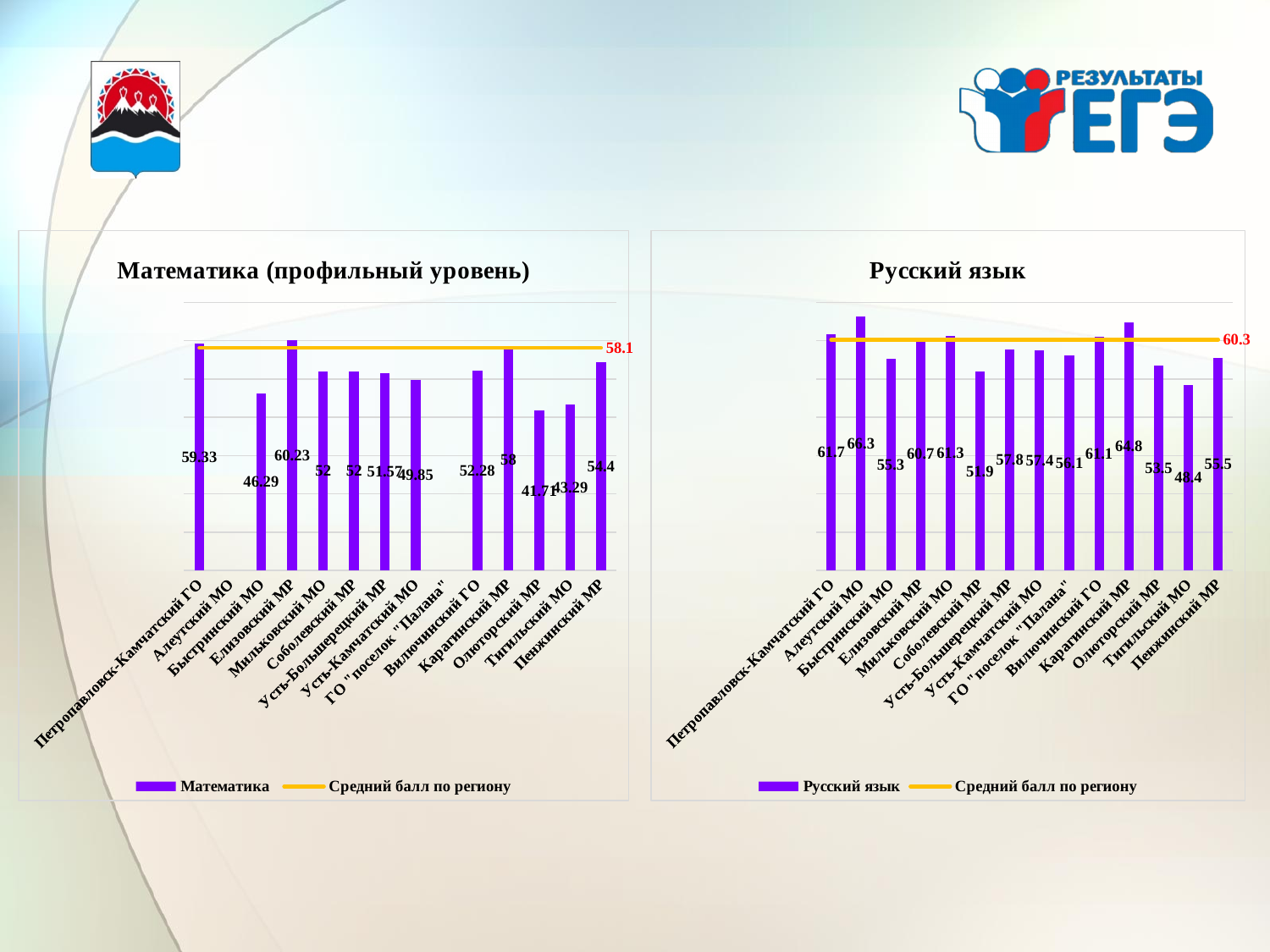
On the Математика (профильный уровень) chart, what is the value of the Средний балл по региону line? 58.1 On the Русский язык chart, which category has the highest value? Алеутский МО On the Математика (профильный уровень) chart, what is the difference between the values for Елизовский МР and Олюторский МР? 18.52 On the Математика (профильный уровень) chart, which category has the highest bar? Елизовский МР On the Русский язык chart, what is the difference between the values for Алеутский МО and Тигильский МО? 17.9 On the Русский язык chart, which category has the lowest value? Тигильский МО On the Математика (профильный уровень) chart, which is larger: the value for Пенжинский МР or for Вилючинский ГО? Пенжинский МР On the Русский язык chart, what is the value for Карагинский МР? 64.8 On the Русский язык chart, what is the value of the Средний балл по региону line? 60.3 How many entries does the legend of the Русский язык chart list? 2 On the Математика (профильный уровень) chart, which category has the lowest bar? Олюторский МР On the Математика (профильный уровень) chart, what is the value for Быстринский МО? 46.29